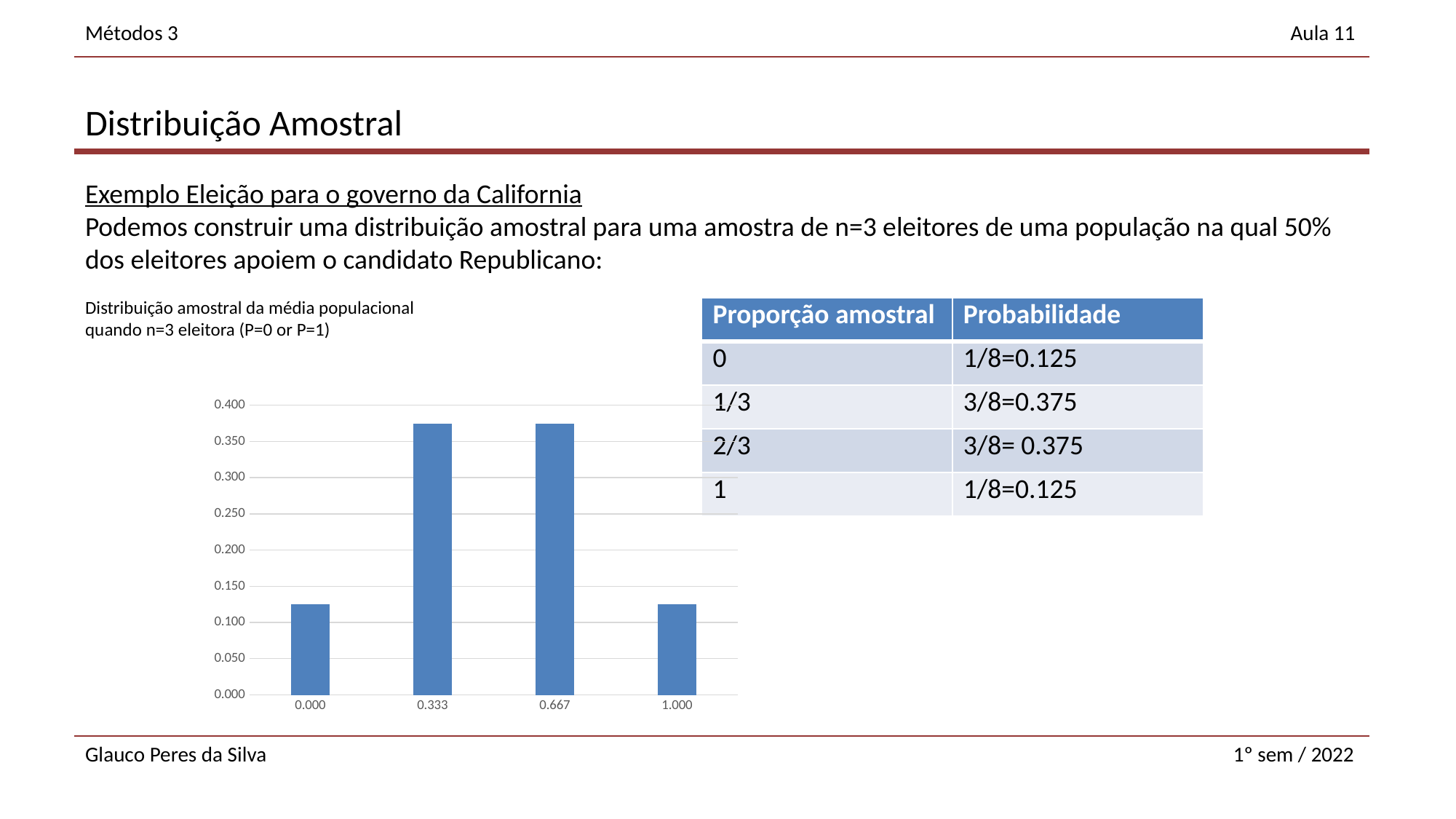
Is the value for 0.000 greater or less than 0.100? greater Is the value for 0.333 greater or less than 0.350? greater What kind of chart is shown on the slide? bar chart Do the values rise or fall from 0.000 to 0.333 along the x axis? rise Is the value for 1.000 greater or less than 0.150? less What is the highest tick value shown on the vertical axis of the chart? 0.400 Which is larger, the value for 0.333 or the value for 0.000? 0.333 What is the title of the chart? Distribuição amostral da média populacional quando n=3 eleitora (P=0 or P=1) How many bars (categories) does the chart show? 4 Do the values rise or fall from 0.667 to 1.000 along the x axis? fall Which is larger, the value for 1.000 or the value for 0.667? 0.667